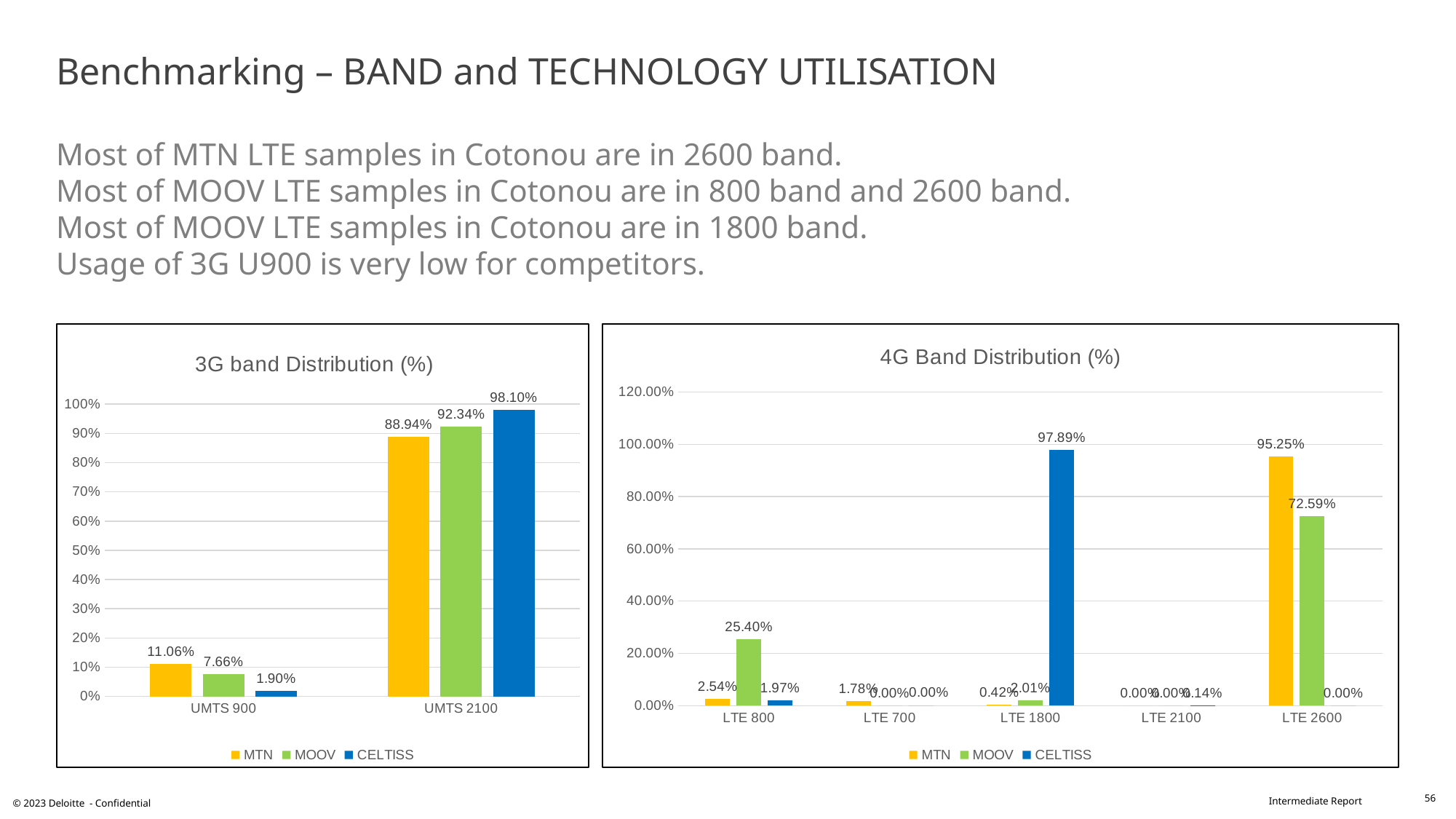
In the 3G band Distribution (%) chart, how many series does the legend list? 3 In the 4G Band Distribution (%) chart, what is the value for CELTISS at LTE 1800? 97.89% In the 4G Band Distribution (%) chart, how many band categories are shown on the x axis? 5 In the 3G band Distribution (%) chart, what is the value for CELTISS at UMTS 2100? 98.10% In the 4G Band Distribution (%) chart, what is the value for MOOV at LTE 800? 25.40% In the 3G band Distribution (%) chart, what is the difference between MOOV and MTN at UMTS 2100? 3.40% In the 3G band Distribution (%) chart, what is the value for MTN at UMTS 900? 11.06% In the 4G Band Distribution (%) chart, what is the difference between MTN and MOOV at LTE 2600? 22.66% In the 4G Band Distribution (%) chart, which operator has the highest value at LTE 2600? MTN In the 4G Band Distribution (%) chart, is the value for MOOV at LTE 2600 greater or less than 80.00%? less In the 3G band Distribution (%) chart, which operator has the lowest value at UMTS 900? CELTISS What type of chart is the 4G Band Distribution (%) chart? Bar chart